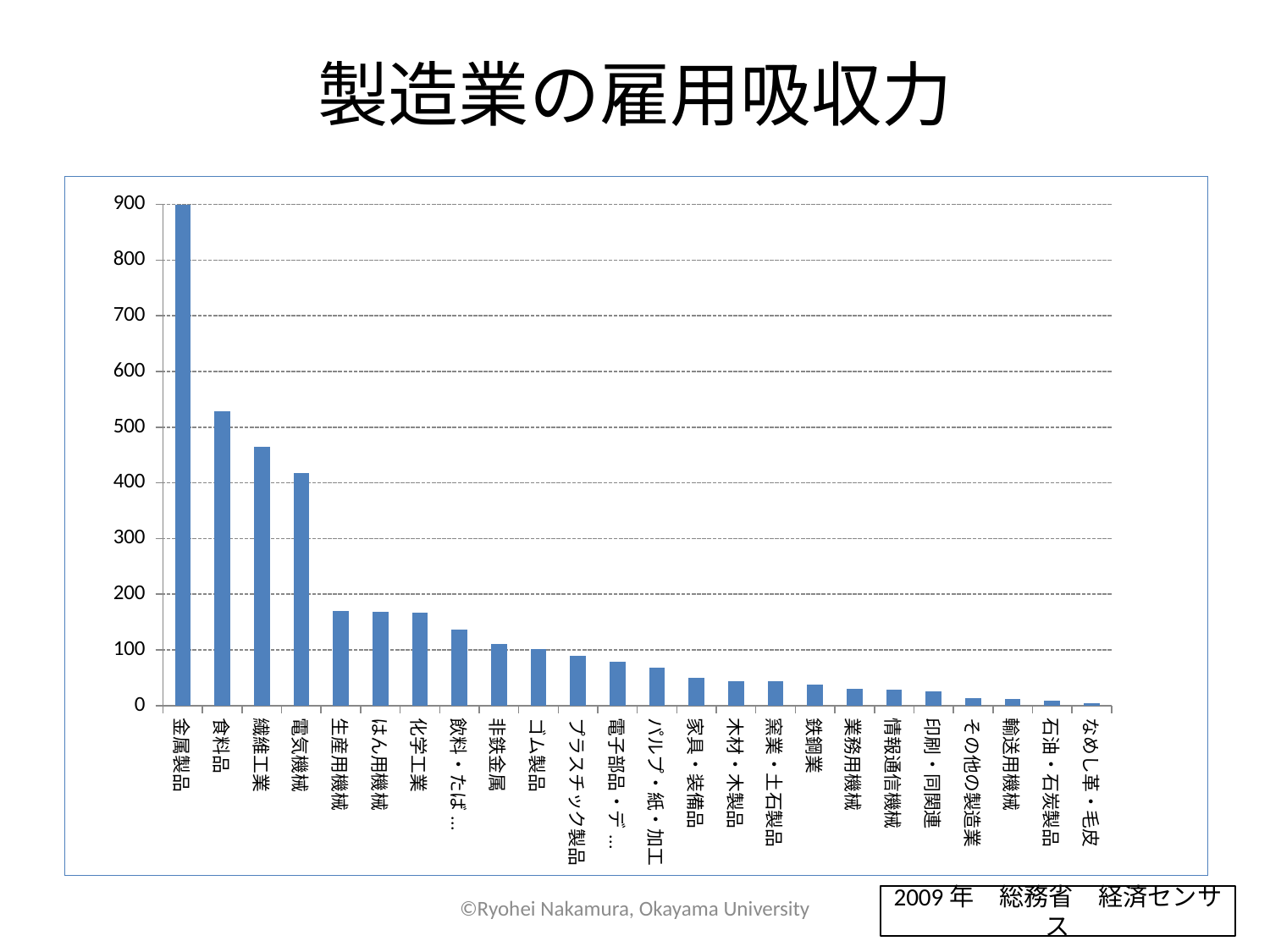
Is the value for 電気機械 greater or less than 400? greater Which is larger, the value for 化学工業 or the value for 非鉄金属? 化学工業 Is the value for 食料品 greater or less than 500? greater How many categories are plotted on the x axis? 24 Which category has the highest value? 金属製品 Is the value for 鉄鋼業 greater or less than 100? less Which category has the lowest value? なめし革・毛皮 What kind of chart is shown on the slide? bar chart Which is larger, the value for 食料品 or the value for 繊維工業? 食料品 Do the values rise or fall moving from left to right along the x axis? fall What is the title of the chart? 製造業の雇用吸収力